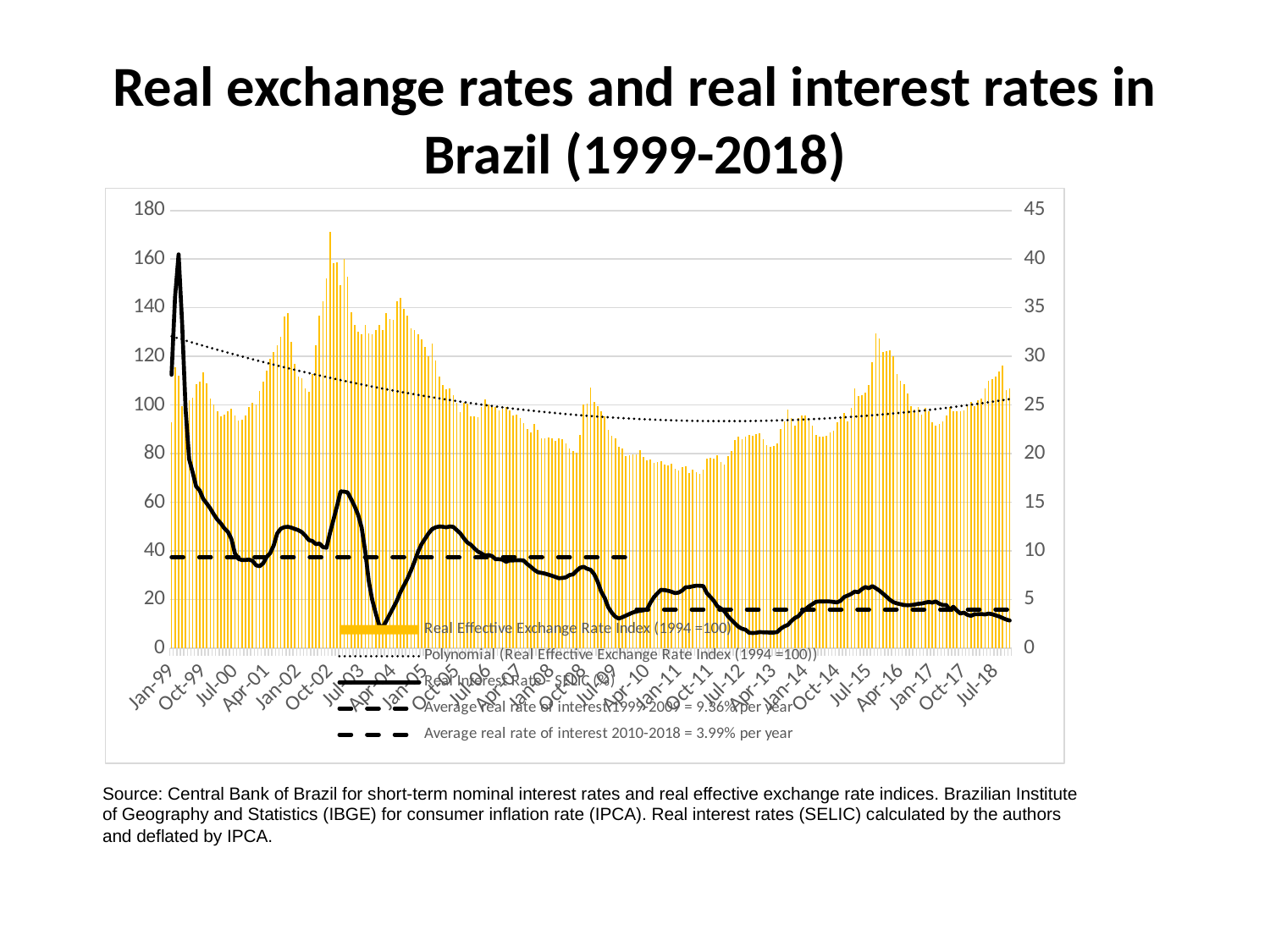
According to the legend, what was the average real rate of interest for 2010-2018? 3.99% per year What is the maximum value shown on the left vertical axis? 180 Is the peak of the Real Interest Rate - SELIC (%) line in 1999 greater or less than 35 on the right axis? greater What kind of chart is shown on the slide? Combination bar and line chart Is the Real Effective Exchange Rate Index around Jan-11 greater or less than 100? less According to the legend, what was the average real rate of interest for 1999-2009? 9.36% per year How many series does the chart's legend list? 5 By how many percentage points does the average real rate of interest for 1999-2009 exceed that for 2010-2018? 5.37 Which period had the higher average real rate of interest, 1999-2009 or 2010-2018? 1999-2009 Is the Real Effective Exchange Rate Index at its peak around Oct-02 greater or less than 150? greater Overall, does the Real Interest Rate - SELIC (%) line rise or fall from 1999 to 2018? fall What is the title of the chart on the slide? Real exchange rates and real interest rates in Brazil (1999-2018)